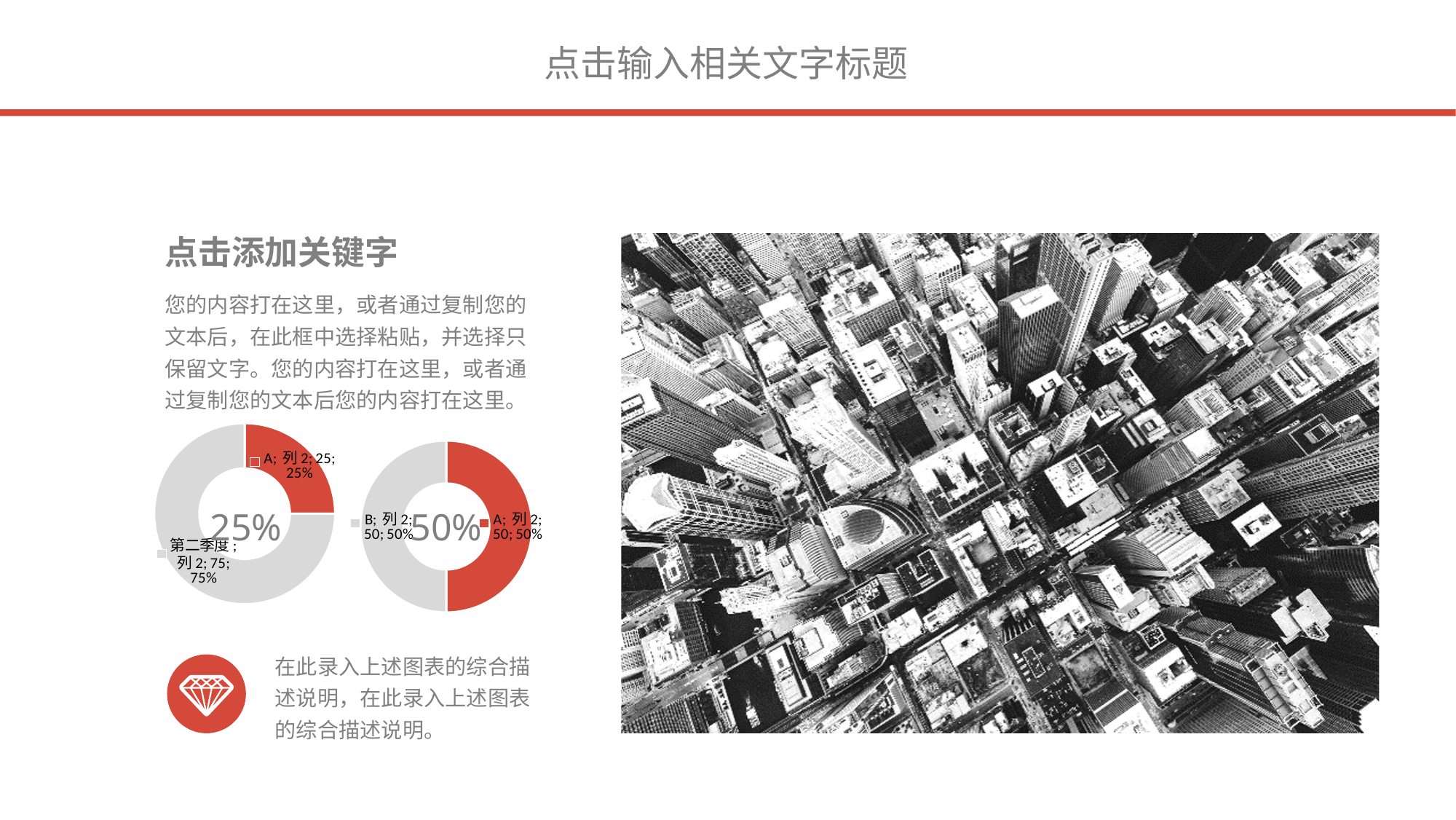
In the left doughnut chart, what is the difference between the values for 第二季度 and A? 50 In the left doughnut chart, which category has the largest share? 第二季度 In the left doughnut chart, what value is shown for category A? 25 In the right doughnut chart, what value is shown for category A? 50 In the left doughnut chart, which category has the smallest share? A What type of chart is the left chart? Doughnut chart In the left doughnut chart, which is larger, the value for A or the value for 第二季度? 第二季度 What number is printed in the centre of the left doughnut chart? 25% In the right doughnut chart, what percentage is shown for category B? 50% How many slices does the left doughnut chart have? 2 In the left doughnut chart, what percentage is shown for 第二季度? 75% What number is printed in the centre of the right doughnut chart? 50%